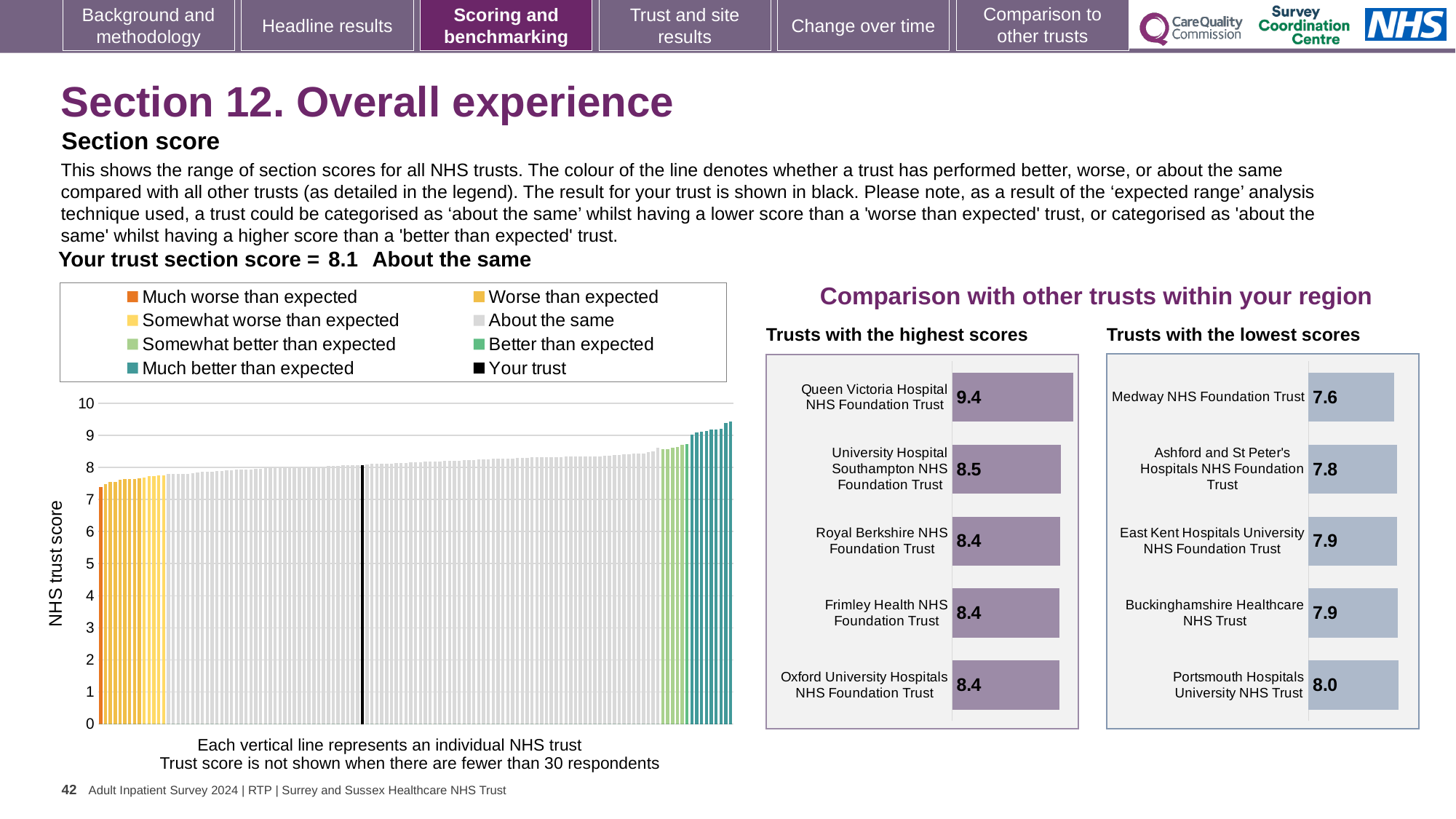
In the large 'NHS trust score' chart, is the value for the black 'Your trust' bar greater or less than 8? greater In the 'Trusts with the lowest scores' chart, what is the difference between the scores of Portsmouth Hospitals University NHS Trust and Medway NHS Foundation Trust? 0.4 In the 'Trusts with the highest scores' chart, which trust has the highest score? Queen Victoria Hospital NHS Foundation Trust In the 'Trusts with the highest scores' chart, what is the difference between the scores of Queen Victoria Hospital NHS Foundation Trust and University Hospital Southampton NHS Foundation Trust? 0.9 In the 'Trusts with the highest scores' chart, what is the score for Queen Victoria Hospital NHS Foundation Trust? 9.4 In the large 'NHS trust score' chart, do the values rise or fall from left to right along the x axis? Rise How many entries does the legend of the large 'NHS trust score' chart list? 8 In the 'Trusts with the lowest scores' chart, which has the larger score: Ashford and St Peter's Hospitals NHS Foundation Trust or Portsmouth Hospitals University NHS Trust? Portsmouth Hospitals University NHS Trust In the 'Trusts with the lowest scores' chart, what is the score for Medway NHS Foundation Trust? 7.6 What kind of chart is the large chart with the 'NHS trust score' axis? Bar chart In the 'Trusts with the lowest scores' chart, which trust has the lowest score? Medway NHS Foundation Trust How many trusts are shown in the 'Trusts with the highest scores' chart? 5